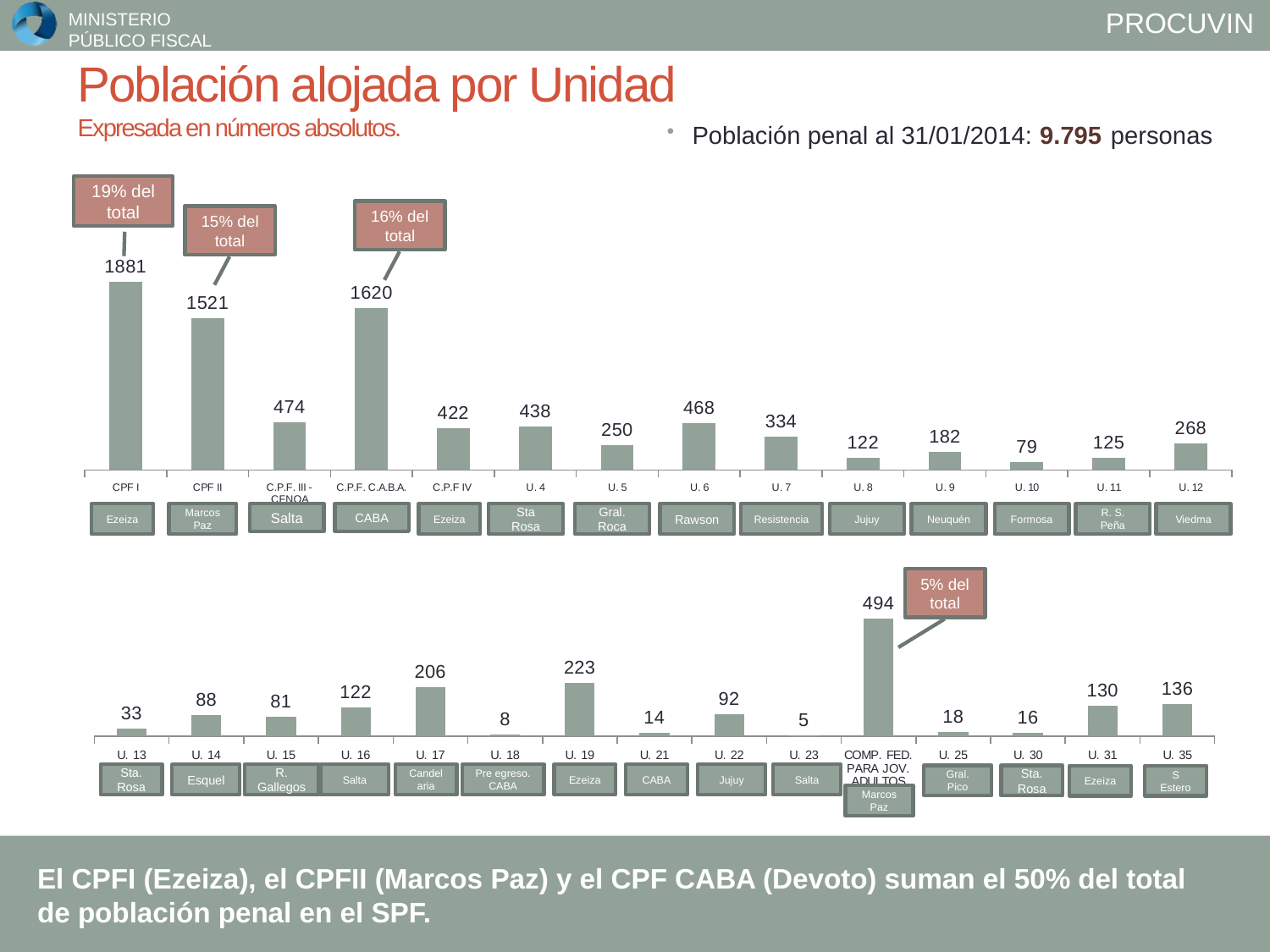
In the bottom chart, which unit has the lowest value? U. 23 In the bottom chart, which unit has the highest value? COMP. FED. PARA JOV. ADULTOS In the bottom chart, what is the difference between U. 35 and U. 31? 6 In the bottom chart, what is the value for U. 19? 223 In the top chart, what is the value for CPF I? 1881 What type of chart is used on this slide? Bar chart In the top chart, what is the difference between CPF I and CPF II? 360 How many units are shown in the top chart? 14 In the top chart, which unit has the lowest value? U. 10 In the top chart, which is larger, U. 4 or U. 5? U. 4 In the top chart, what is the value for U. 6? 468 According to the label above CPF I in the top chart, what share of the total does it represent? 19% del total